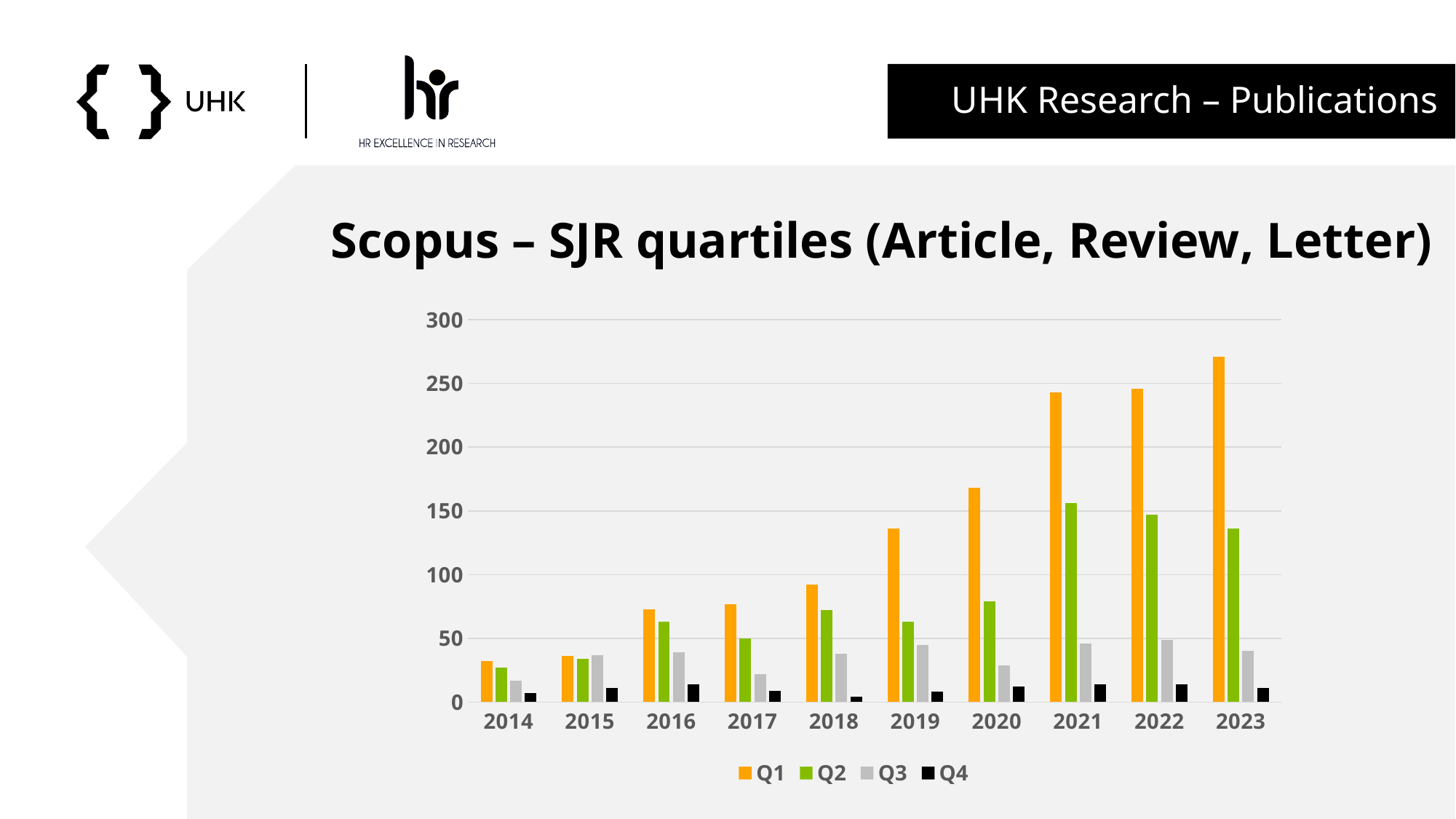
In 2023, which is larger, the Q1 value or the Q2 value? Q1 Is the Q1 value for 2023 greater or less than 250? greater Is the Q1 value for 2020 greater or less than 150? greater In which year is the Q1 value lowest? 2014 What is the title of the chart? Scopus – SJR quartiles (Article, Review, Letter) In which year is the Q1 value highest? 2023 Is the Q1 value for 2019 greater or less than 150? less Do the Q1 values generally rise or fall from 2014 to 2023? rise What kind of chart is shown on the slide? bar chart How many years are shown on the x axis? 10 How many series does the legend list? 4